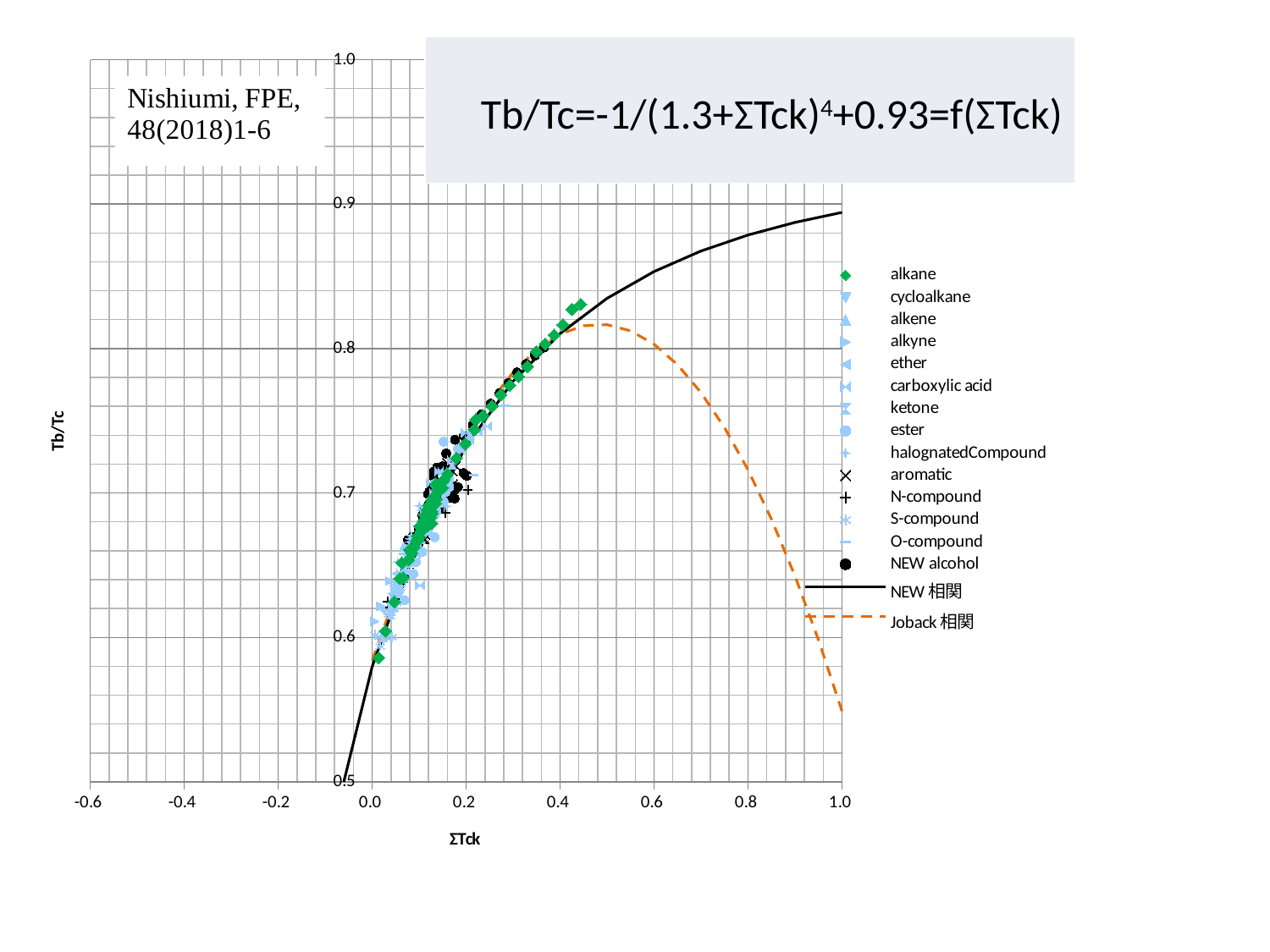
How many entries does the legend list? 16 Does the NEW 相関 curve rise or fall as ΣTck increases from 0.0 to 1.0? rise What is the label of the x axis? ΣTck Is the value of the NEW 相関 curve at ΣTck = 1.0 greater or less than 0.8? greater Does the Joback 相関 curve rise or fall as ΣTck increases from 0.6 to 1.0? fall Is the value of the Joback 相関 curve at ΣTck = 1.0 greater or less than 0.6? less What is the label of the y axis? Tb/Tc At ΣTck = 1.0, which curve has the higher Tb/Tc value, NEW 相関 or Joback 相関? NEW 相関 Is the maximum value of the Joback 相関 curve greater or less than 0.9? less What kind of chart is shown on the slide? scatter chart